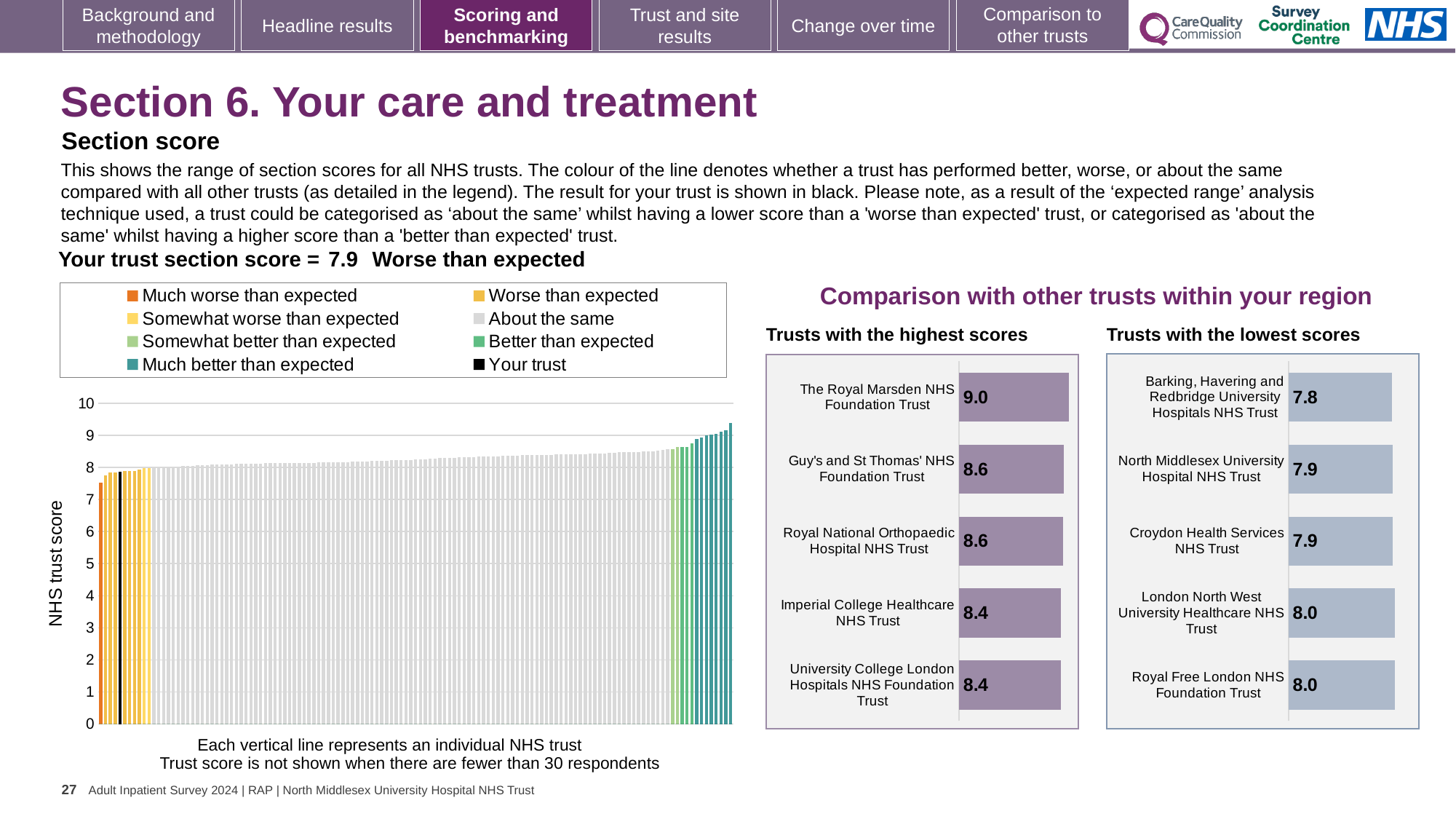
In the 'Trusts with the highest scores' chart, which trust has the highest score? The Royal Marsden NHS Foundation Trust In the 'Trusts with the lowest scores' chart, which has the larger score: Royal Free London NHS Foundation Trust or Croydon Health Services NHS Trust? Royal Free London NHS Foundation Trust What kind of chart is the large chart on the left showing NHS trust scores? Bar chart In the 'Trusts with the lowest scores' chart, which trust has the lowest score? Barking, Havering and Redbridge University Hospitals NHS Trust In the large chart on the left, do the bar heights rise or fall from left to right? Rise How many entries does the legend above the large chart on the left list? 8 In the large chart on the left, what is the label on the vertical axis? NHS trust score In the 'Trusts with the highest scores' chart, what is the score for The Royal Marsden NHS Foundation Trust? 9.0 In the large chart on the left, is the value of the tallest bar greater or less than 9? greater In the 'Trusts with the lowest scores' chart, what is the score for Barking, Havering and Redbridge University Hospitals NHS Trust? 7.8 How many trusts are shown in the 'Trusts with the highest scores' chart? 5 In the 'Trusts with the highest scores' chart, what is the difference between the scores of The Royal Marsden NHS Foundation Trust and Guy's and St Thomas' NHS Foundation Trust? 0.4